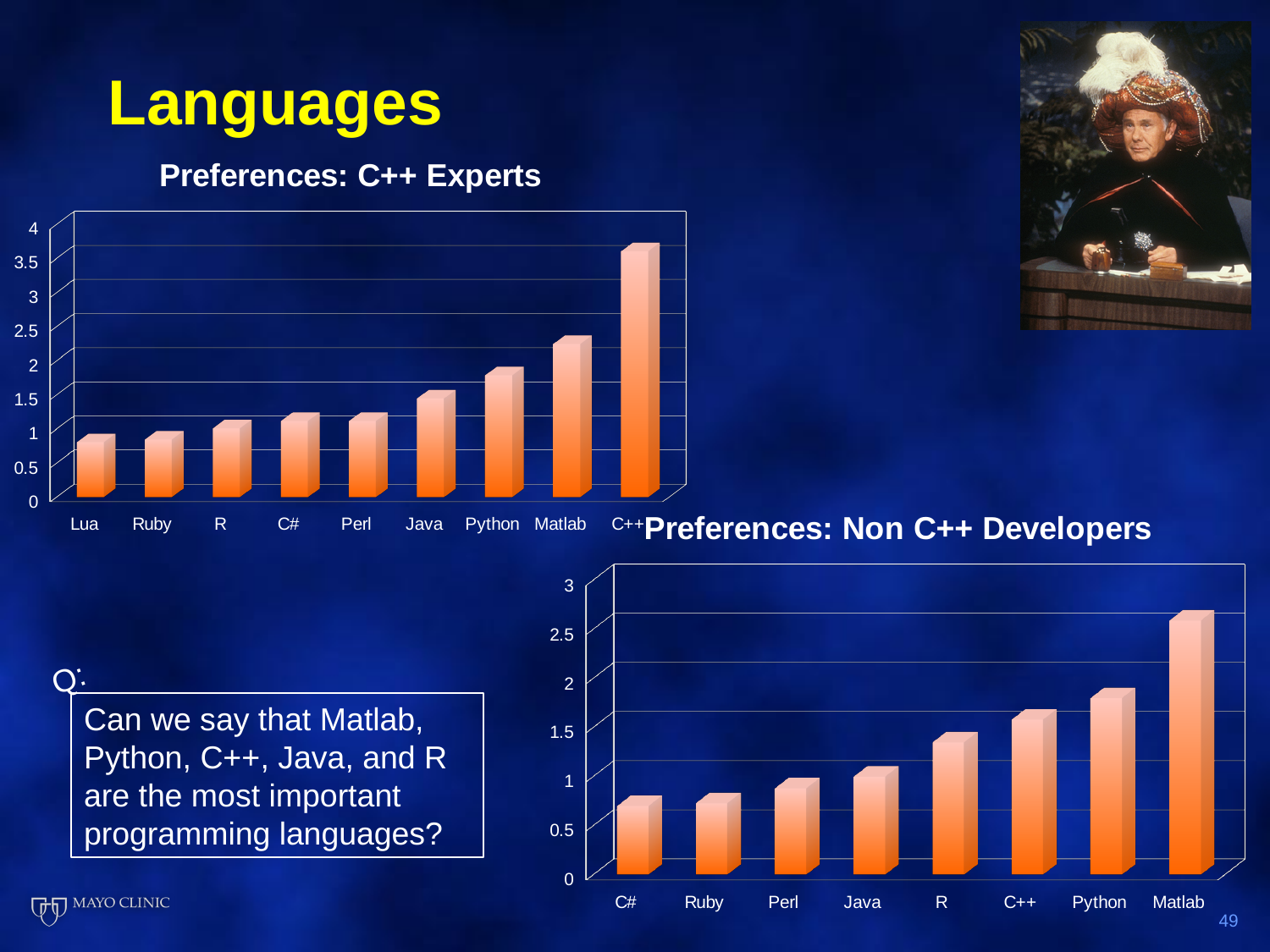
In the 'Preferences: Non C++ Developers' chart, which has the larger value, Python or Java? Python How many languages are shown in the 'Preferences: Non C++ Developers' chart? 8 How many languages are shown in the 'Preferences: C++ Experts' chart? 9 In the 'Preferences: C++ Experts' chart, which has the larger value, Matlab or Perl? Matlab In the 'Preferences: C++ Experts' chart, is the value for Lua greater or less than 1? less In the 'Preferences: C++ Experts' chart, which language has the highest value? C++ In the 'Preferences: C++ Experts' chart, do the values rise or fall from left to right along the x axis? Rise In the 'Preferences: Non C++ Developers' chart, is the value for C# greater or less than 1? less What type of chart is the 'Preferences: Non C++ Developers' chart? Bar chart In the 'Preferences: C++ Experts' chart, is the value for C++ greater or less than 3? greater In the 'Preferences: Non C++ Developers' chart, which language has the highest value? Matlab